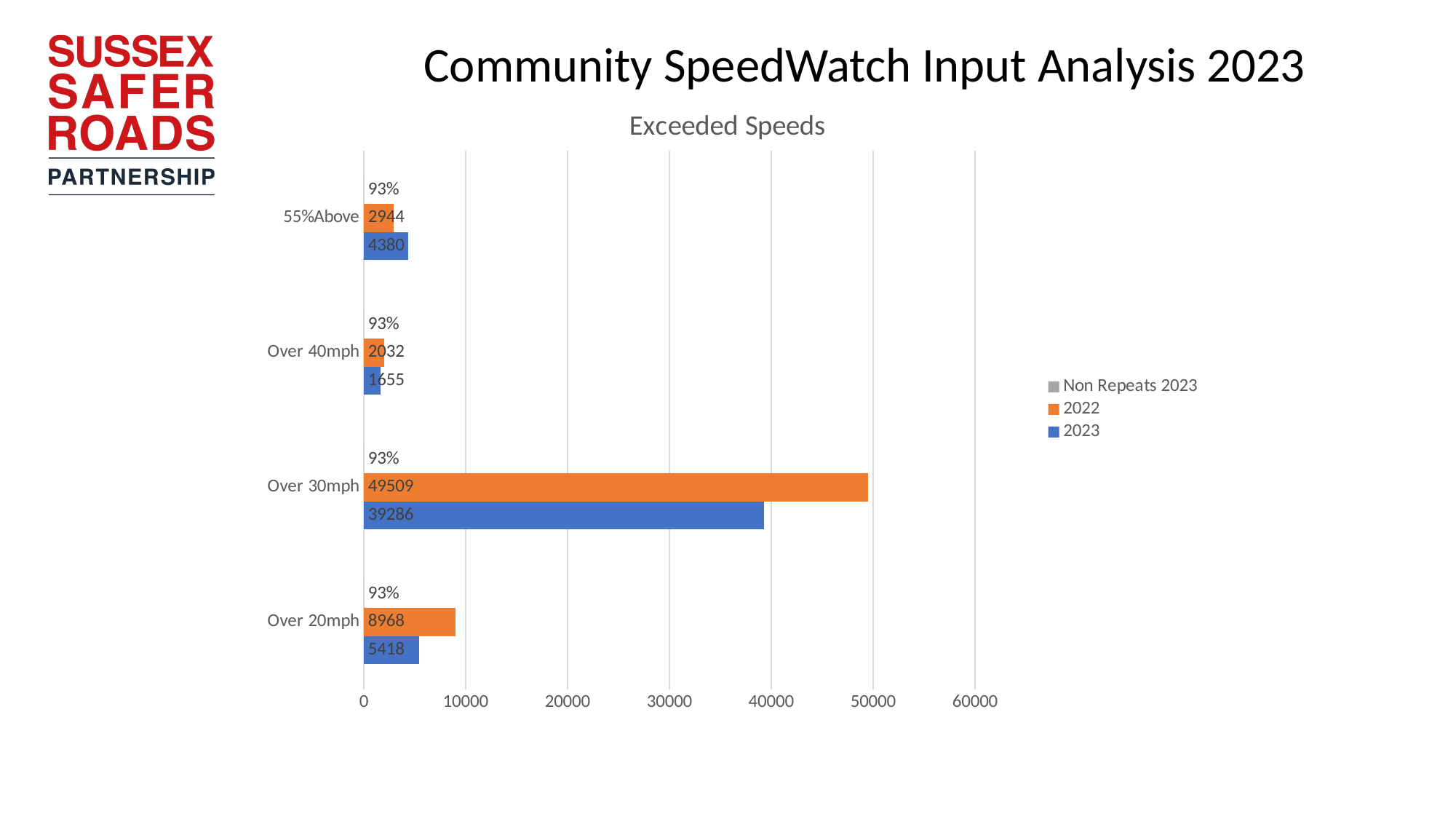
Which category has the highest 2023 value? Over 30mph How many series does the legend list? 3 How many categories are shown on the y axis? 4 What is the 2022 value for Over 30mph? 49509 What is the 2023 value for Over 20mph? 5418 What is the 2023 value for 55%Above? 4380 What is the difference between the 2022 and 2023 values for Over 30mph? 10223 What kind of chart is shown? bar chart What is the 2022 value for Over 40mph? 2032 Which is larger for 55%Above, the 2022 value or the 2023 value? 2023 Is the 2023 value for Over 30mph greater or less than 40000? less Which category has the lowest 2022 value? Over 40mph